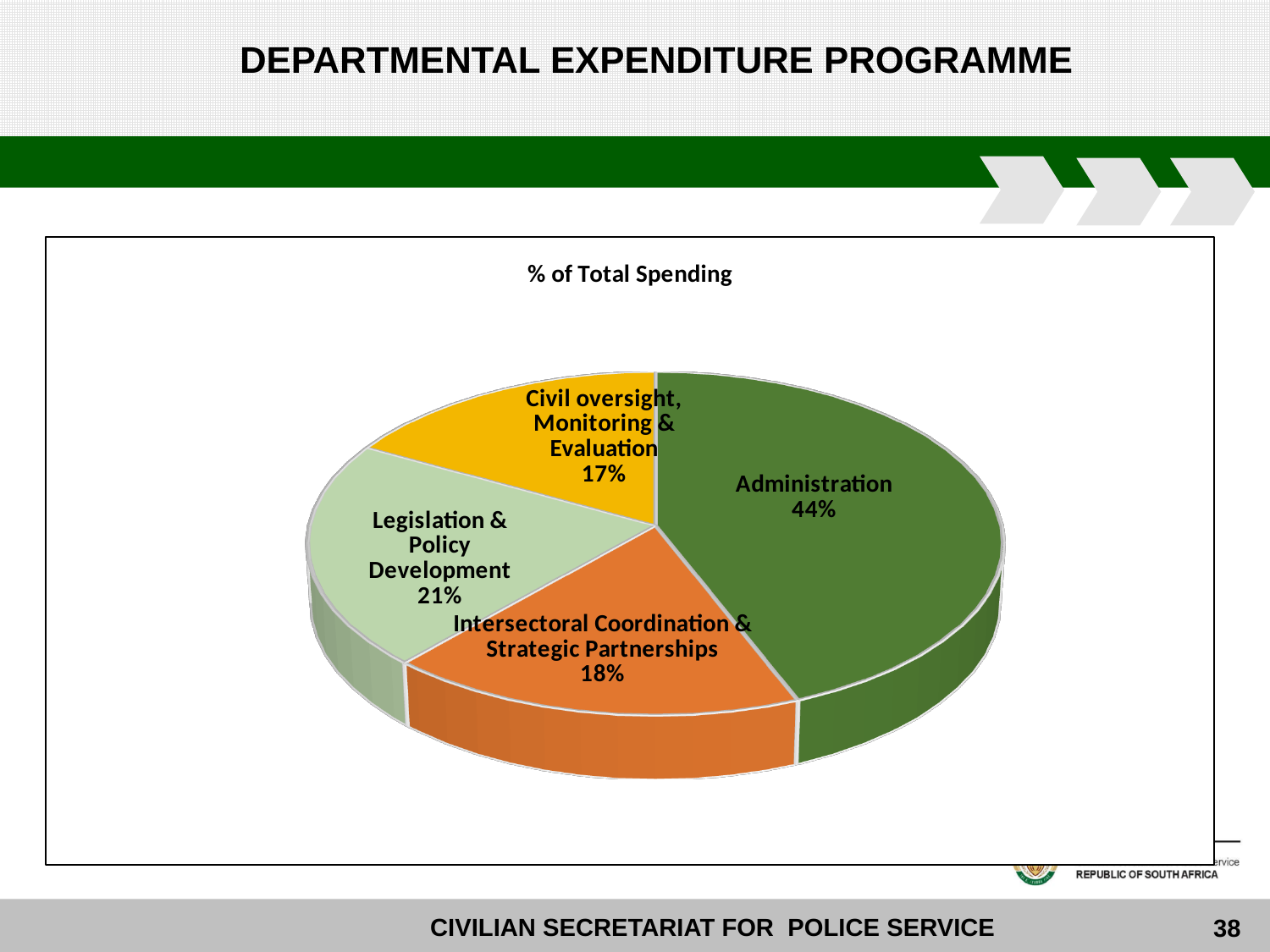
What share of total spending goes to Civil oversight, Monitoring & Evaluation? 17% Which programme has the smallest share of total spending? Civil oversight, Monitoring & Evaluation Which has a larger share of total spending, Legislation & Policy Development or Intersectoral Coordination & Strategic Partnerships? Legislation & Policy Development What is the difference in percentage points between Intersectoral Coordination & Strategic Partnerships and Civil oversight, Monitoring & Evaluation? 1 What is the difference in percentage points between Administration and Legislation & Policy Development? 23 What is the title of the chart? % of Total Spending What share of total spending goes to Intersectoral Coordination & Strategic Partnerships? 18% What kind of chart is shown on the slide? Pie chart What share of total spending goes to Administration? 44% What share of total spending goes to Legislation & Policy Development? 21% Which programme has the largest share of total spending? Administration How many programmes are shown in the pie chart? 4